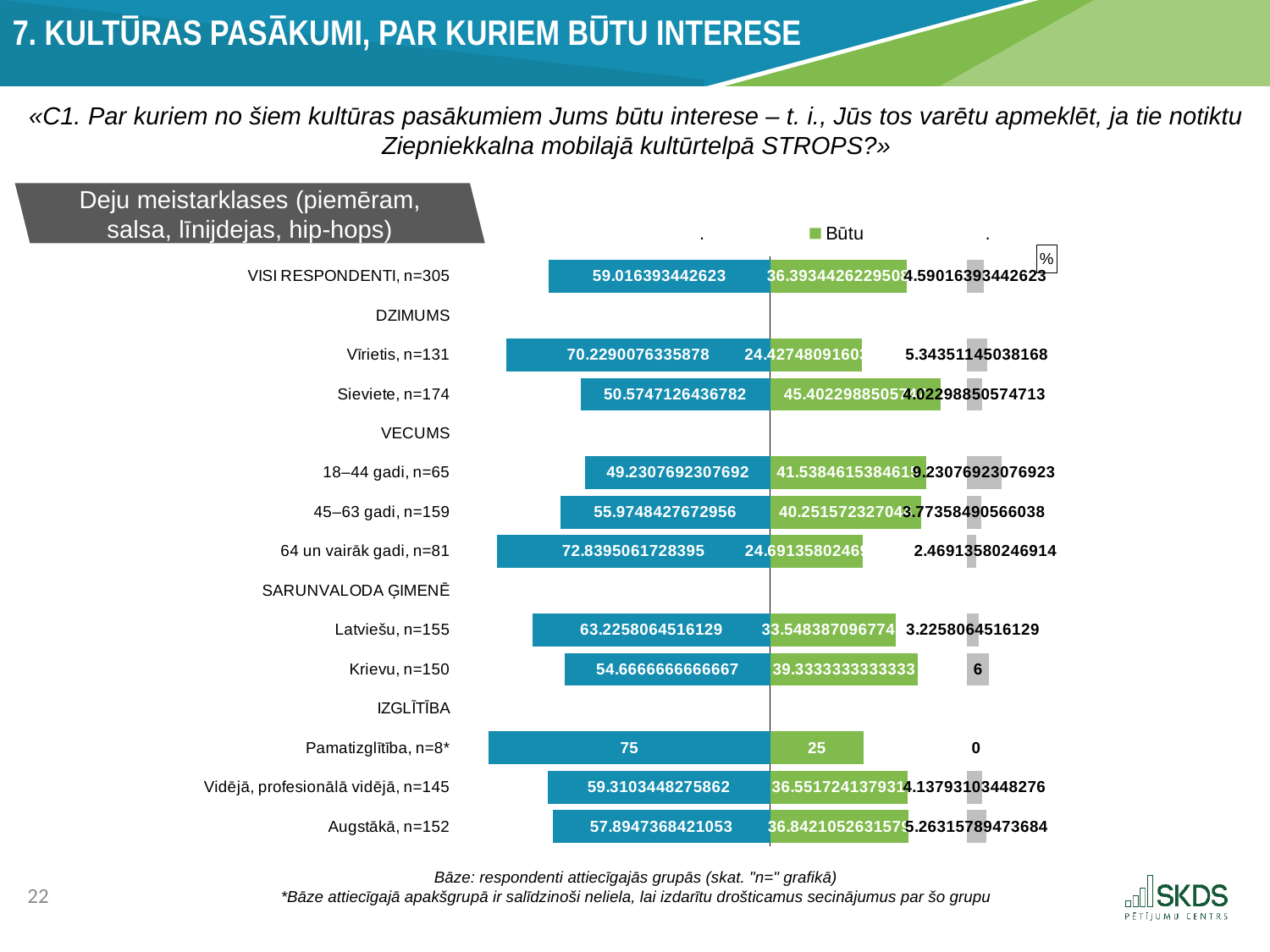
Which has a larger Būtu value, Krievu, n=150 or Latviešu, n=155? Krievu, n=150 What is the value of the grey bar for Krievu, n=150? 6 What is the Būtu value for Pamatizglītība, n=8*? 25 Which group has the highest value in the grey series? 18–44 gadi, n=65 What is the total of the three values shown for Pamatizglītība, n=8*? 100 Which group has the highest value in the blue series? Pamatizglītība, n=8* What is the Būtu value for Krievu, n=150? 39.3333333333333 For Pamatizglītība, n=8*, what is the difference between the blue bar value and the Būtu value? 50 Which series name is readable in the chart legend? Būtu Which group has the lowest value in the blue series? 18–44 gadi, n=65 What type of chart is shown on the slide? Bar chart What is the value of the blue bar for 64 un vairāk gadi, n=81? 72.8395061728395